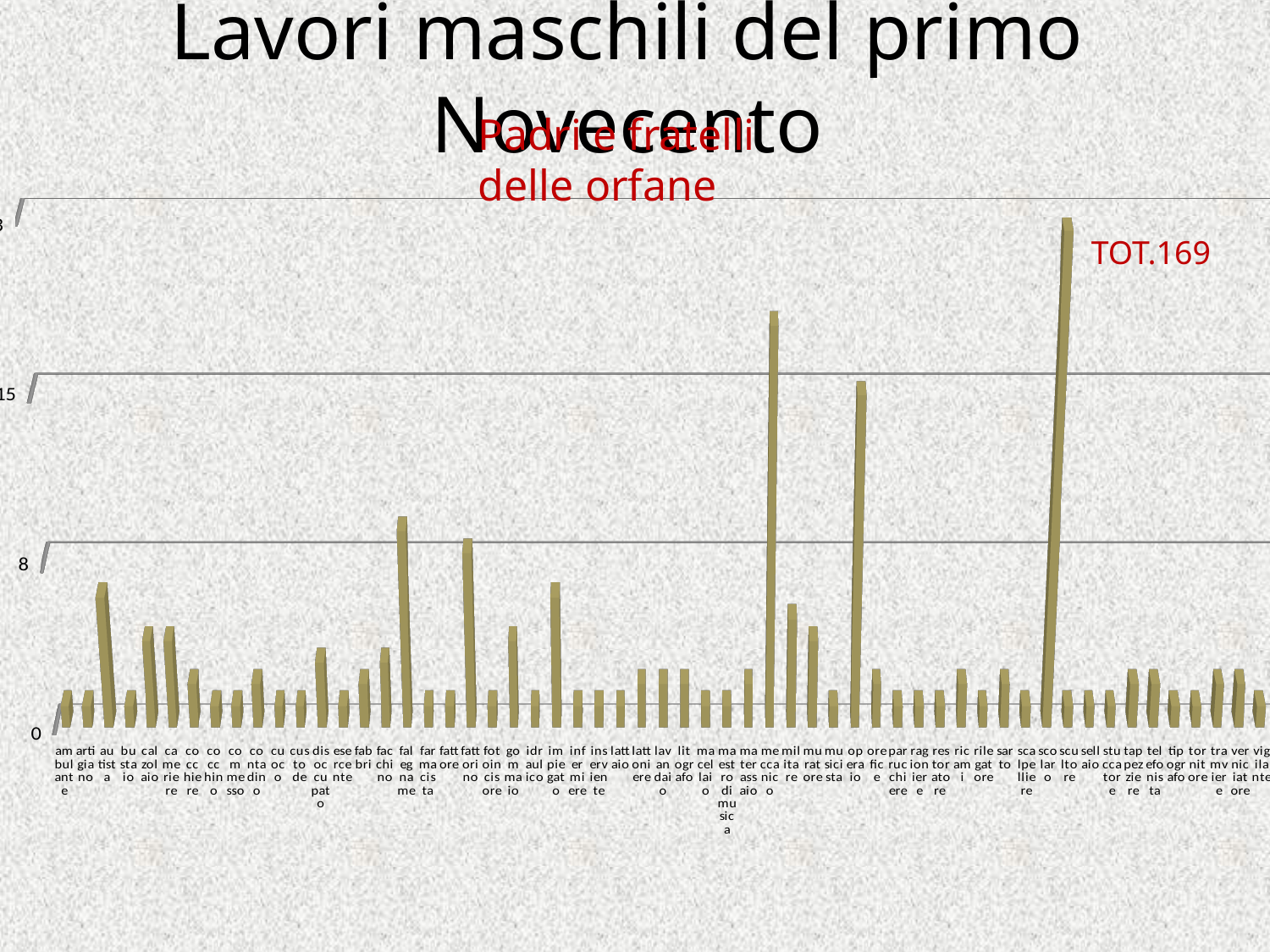
Which is larger, the value for falegname or the value for calzolaio? falegname Is the value for militare greater or less than 8? less Is the value for ambulante greater or less than 8? less Is the value for meccanico greater or less than 15? greater Which is larger, the value for meccanico or the value for operaio? meccanico Which is larger, the value for scultore or the value for meccanico? meccanico What kind of chart is shown on the slide? bar chart Which category has the highest bar? scolaro What is the title of the chart? Lavori maschili del primo Novecento What total is annotated in red on the chart? TOT.169